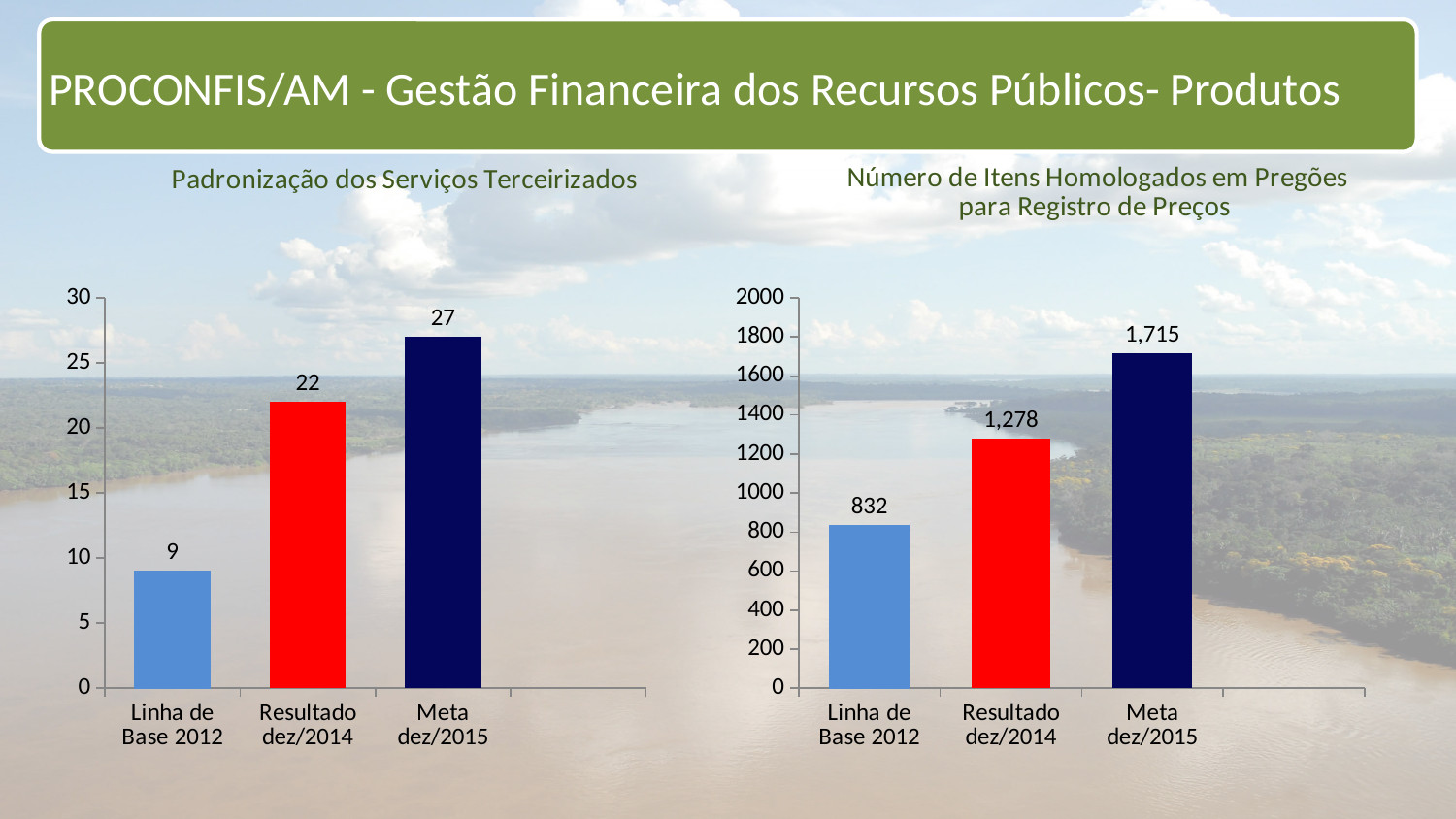
In the 'Padronização dos Serviços Terceirizados' chart, what is the value for Resultado dez/2014? 22 In the 'Número de Itens Homologados em Pregões para Registro de Preços' chart, what is the value for Meta dez/2015? 1,715 In the 'Número de Itens Homologados em Pregões para Registro de Preços' chart, which category has the lowest value? Linha de Base 2012 In the 'Número de Itens Homologados em Pregões para Registro de Preços' chart, what is the value for Linha de Base 2012? 832 In the 'Padronização dos Serviços Terceirizados' chart, what is the value for Linha de Base 2012? 9 What kind of chart is the 'Número de Itens Homologados em Pregões para Registro de Preços' chart? bar chart In the 'Número de Itens Homologados em Pregões para Registro de Preços' chart, is the value for Resultado dez/2014 greater or less than 1200? greater How many categories are shown in the 'Padronização dos Serviços Terceirizados' chart? 3 In the 'Padronização dos Serviços Terceirizados' chart, which category has the highest value? Meta dez/2015 In the 'Padronização dos Serviços Terceirizados' chart, what is the difference between Meta dez/2015 and Resultado dez/2014? 5 In the 'Padronização dos Serviços Terceirizados' chart, do the values rise or fall from left to right? rise In the 'Número de Itens Homologados em Pregões para Registro de Preços' chart, what is the difference between Resultado dez/2014 and Linha de Base 2012? 446